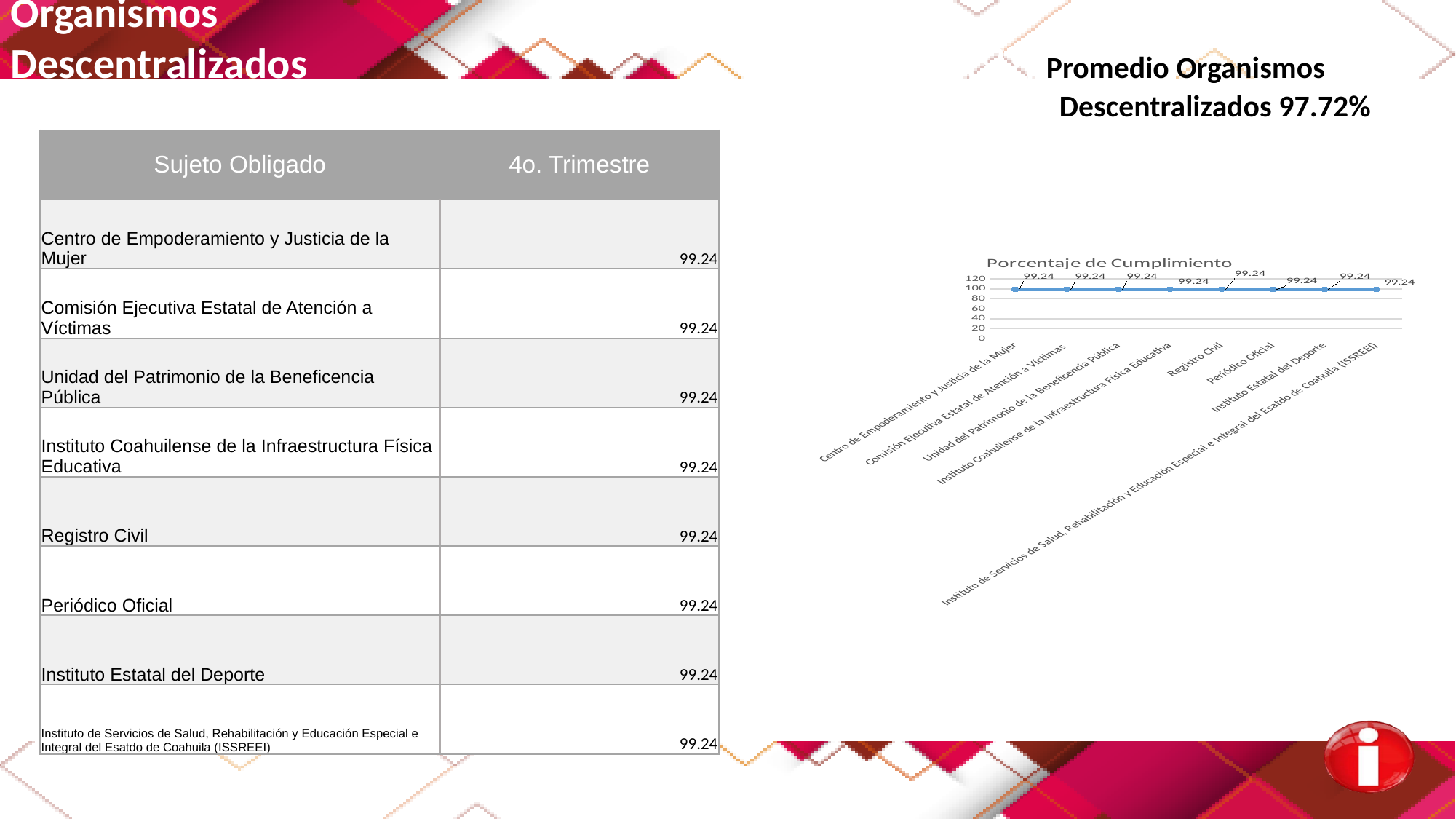
Is the value for Registro Civil in the Porcentaje de Cumplimiento chart greater or less than 80? greater Is the value for Periódico Oficial in the Porcentaje de Cumplimiento chart greater or less than 120? less What is the value for Periódico Oficial in the Porcentaje de Cumplimiento chart? 99.24 What is the value for Registro Civil in the Porcentaje de Cumplimiento chart? 99.24 What is the value for Instituto Estatal del Deporte in the Porcentaje de Cumplimiento chart? 99.24 What is the value for Centro de Empoderamiento y Justicia de la Mujer in the Porcentaje de Cumplimiento chart? 99.24 What kind of chart is the Porcentaje de Cumplimiento chart? line chart What is the value for Unidad del Patrimonio de la Beneficencia Pública in the Porcentaje de Cumplimiento chart? 99.24 What is the title of the chart on the slide? Porcentaje de Cumplimiento Do the values in the Porcentaje de Cumplimiento chart rise, fall, or stay flat along the x axis? stay flat What is the difference between the values for Registro Civil and Periódico Oficial in the Porcentaje de Cumplimiento chart? 0 How many categories are plotted in the Porcentaje de Cumplimiento chart? 8